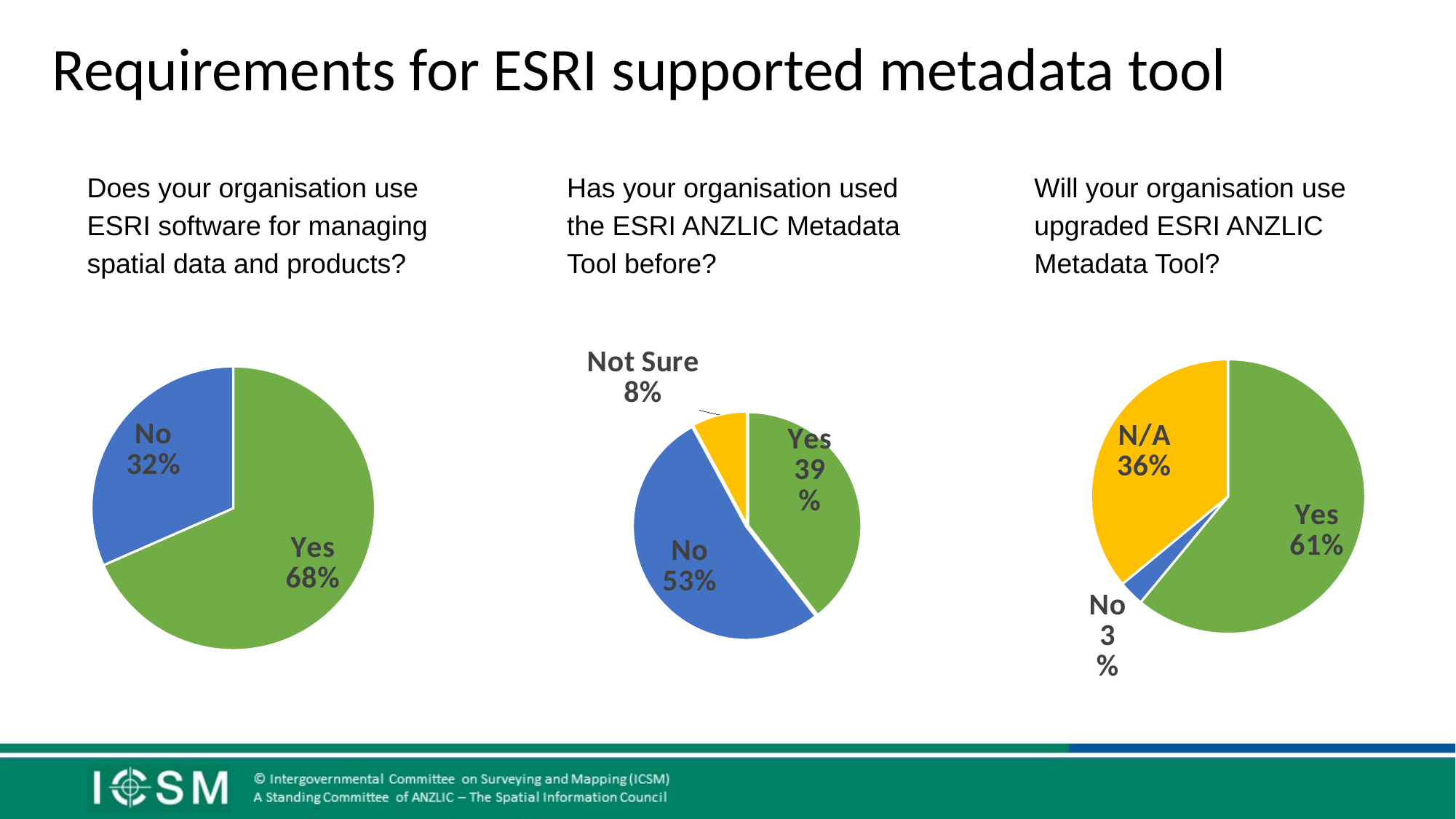
In the middle pie chart (Has your organisation used the ESRI ANZLIC Metadata Tool before?), what share of responses is 'No'? 53% In the middle pie chart (Has your organisation used the ESRI ANZLIC Metadata Tool before?), which response has the largest share? No In the right pie chart (Will your organisation use upgraded ESRI ANZLIC Metadata Tool?), how many slices does the pie have? 3 In the right pie chart (Will your organisation use upgraded ESRI ANZLIC Metadata Tool?), what share of responses is 'No'? 3% In the middle pie chart (Has your organisation used the ESRI ANZLIC Metadata Tool before?), which is larger, 'Yes' or 'No'? No What type of chart is used for each of the three charts on the slide? Pie chart In the left pie chart (Does your organisation use ESRI software for managing spatial data and products?), what is the difference between the 'Yes' and 'No' shares? 36% In the right pie chart (Will your organisation use upgraded ESRI ANZLIC Metadata Tool?), what share of responses is 'N/A'? 36% In the middle pie chart (Has your organisation used the ESRI ANZLIC Metadata Tool before?), which response has the smallest share? Not Sure